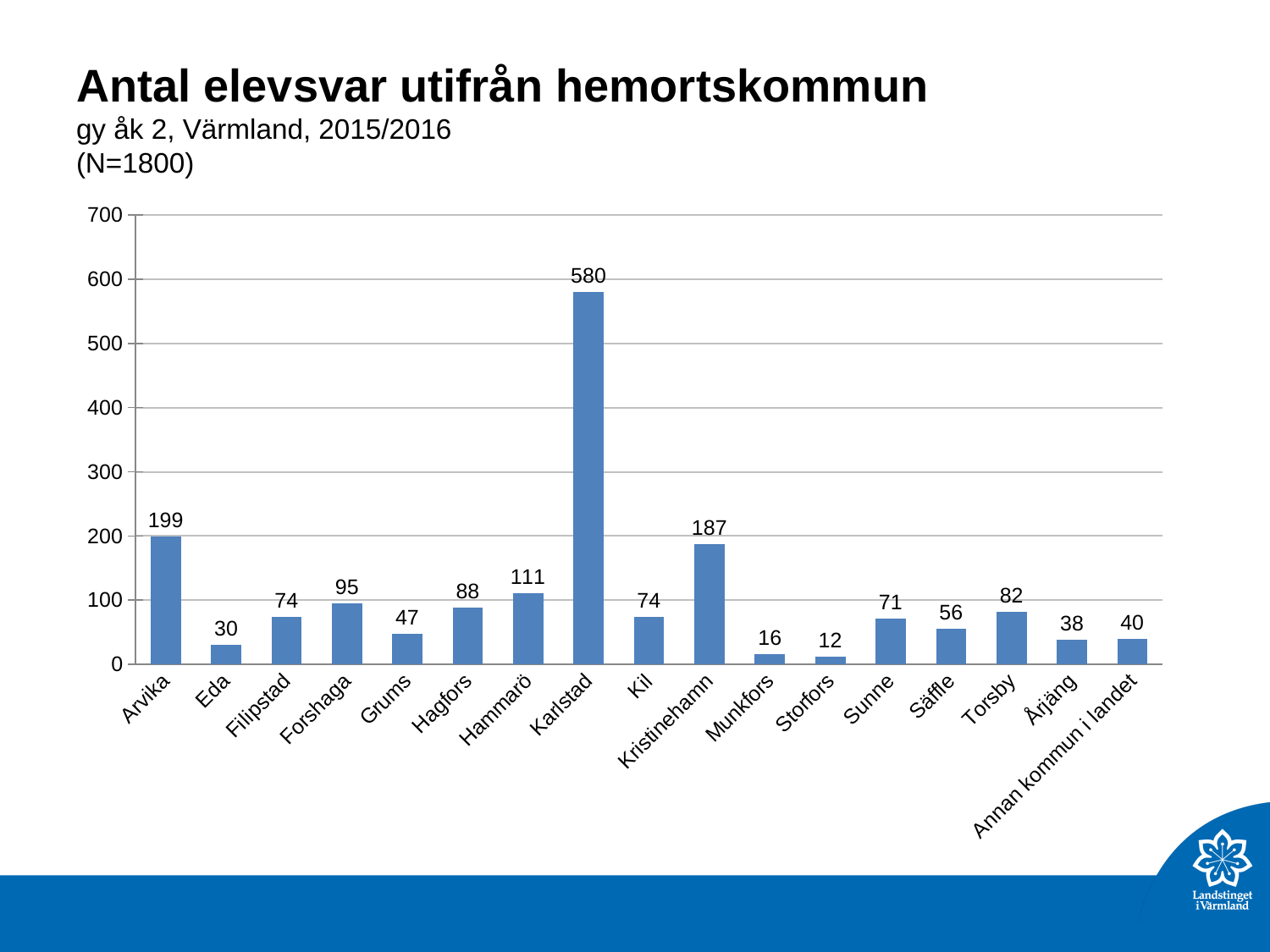
What kind of chart is shown on the slide? bar chart Which is larger, the value for Hammarö or the value for Forshaga? Hammarö What is the title of the chart? Antal elevsvar utifrån hemortskommun What is the value for Annan kommun i landet? 40 Which category has the lowest value? Storfors What is the value for Karlstad? 580 How many categories are shown on the x axis? 17 What is the value for Kristinehamn? 187 What is the difference between the values for Arvika and Kristinehamn? 12 Is the value for Karlstad greater or less than 500? greater Which category has the highest value? Karlstad What is the difference between the values for Torsby and Säffle? 26